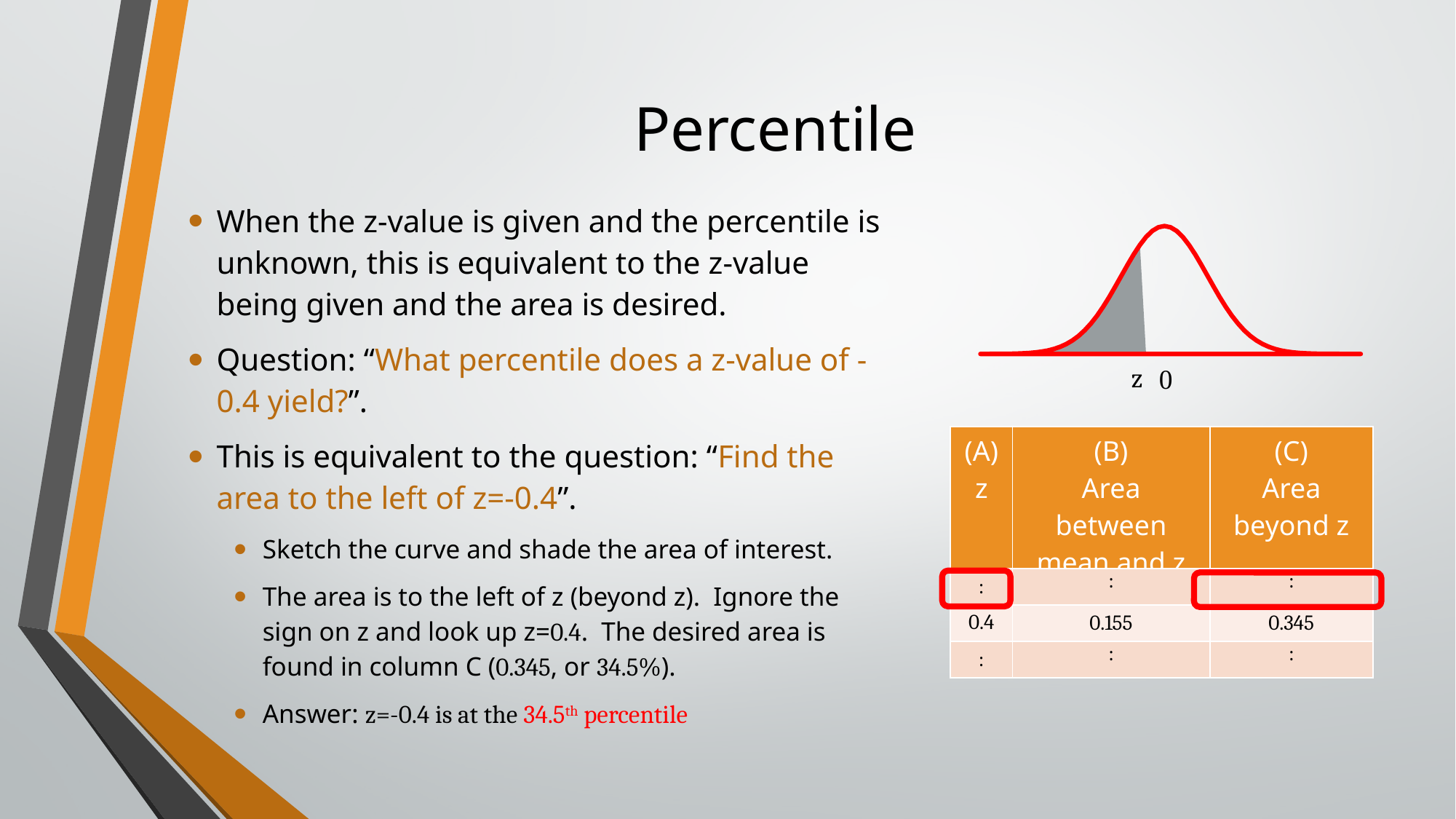
What kind of chart is shown at the top right of the slide? A normal distribution (bell) curve In the table below the curve, what is the heading of column (C)? Area beyond z In the table below the curve, what is the value in column (B) for z = 0.4? 0.155 In the bell curve diagram, which side of z is shaded? The left side (area to the left of z) What two labels appear beneath the horizontal axis of the bell curve diagram? z and 0 How many columns does the table below the curve have? 3 In the table below the curve, what is the value in column (C) for z = 0.4? 0.345 In the table below the curve, which is larger for z = 0.4: the value in column (B) or column (C)? Column (C) In the table below the curve, what is the difference between the column (C) and column (B) values for z = 0.4? 0.190